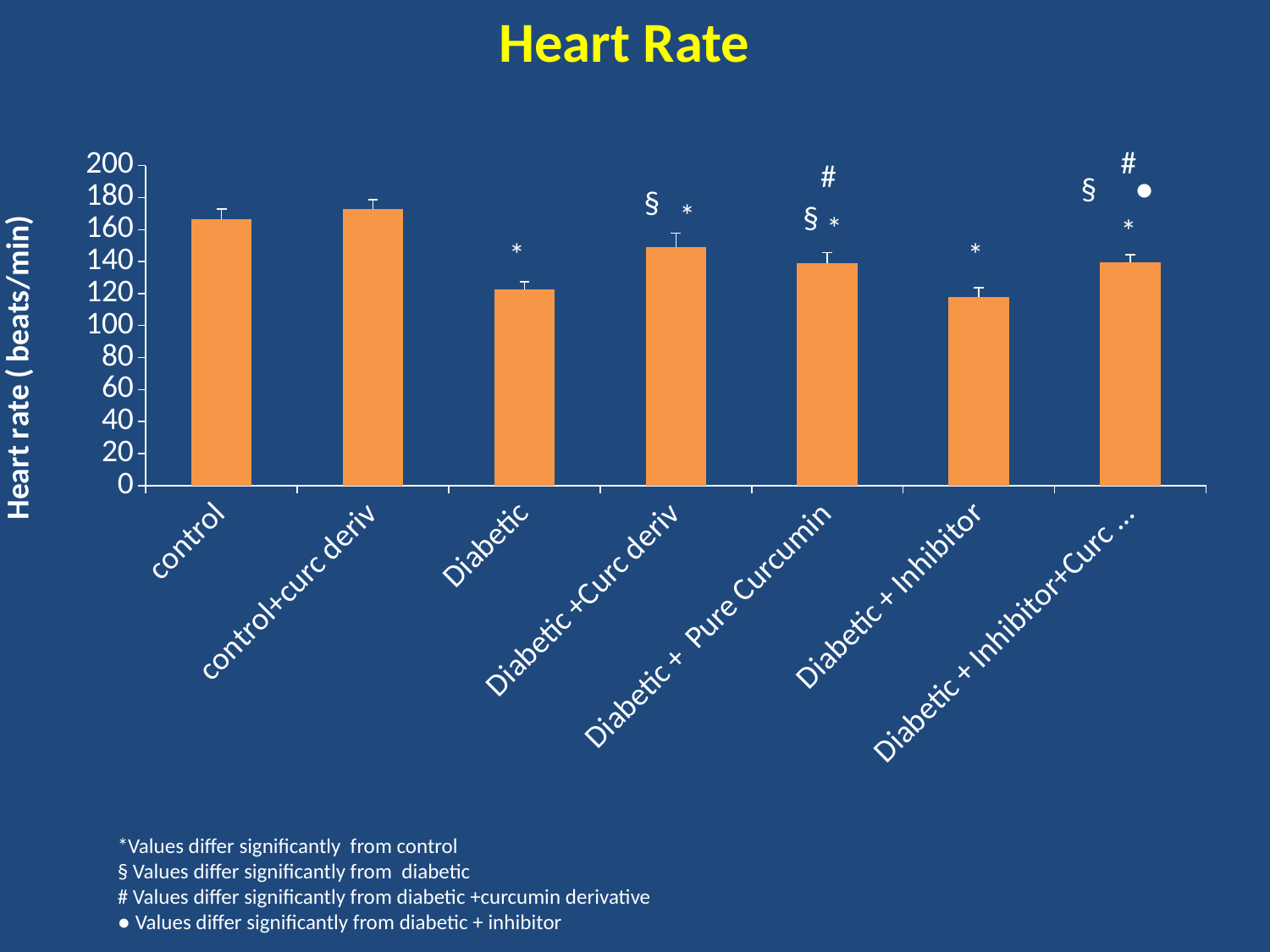
Is the value for Diabetic greater or less than 140? less What is the label on the vertical axis of the chart? Heart rate ( beats/min) Is the value for control greater or less than 160? greater Is the value for Diabetic + Pure Curcumin greater or less than 160? less Which has the higher heart rate, control or Diabetic? control How many bars (categories) are plotted in the chart? 7 What is the title of the chart? Heart Rate Which category has the highest heart rate in the chart? control+curc deriv What kind of chart is shown on the slide? bar chart Which has the higher heart rate, Diabetic +Curc deriv or Diabetic + Pure Curcumin? Diabetic +Curc deriv